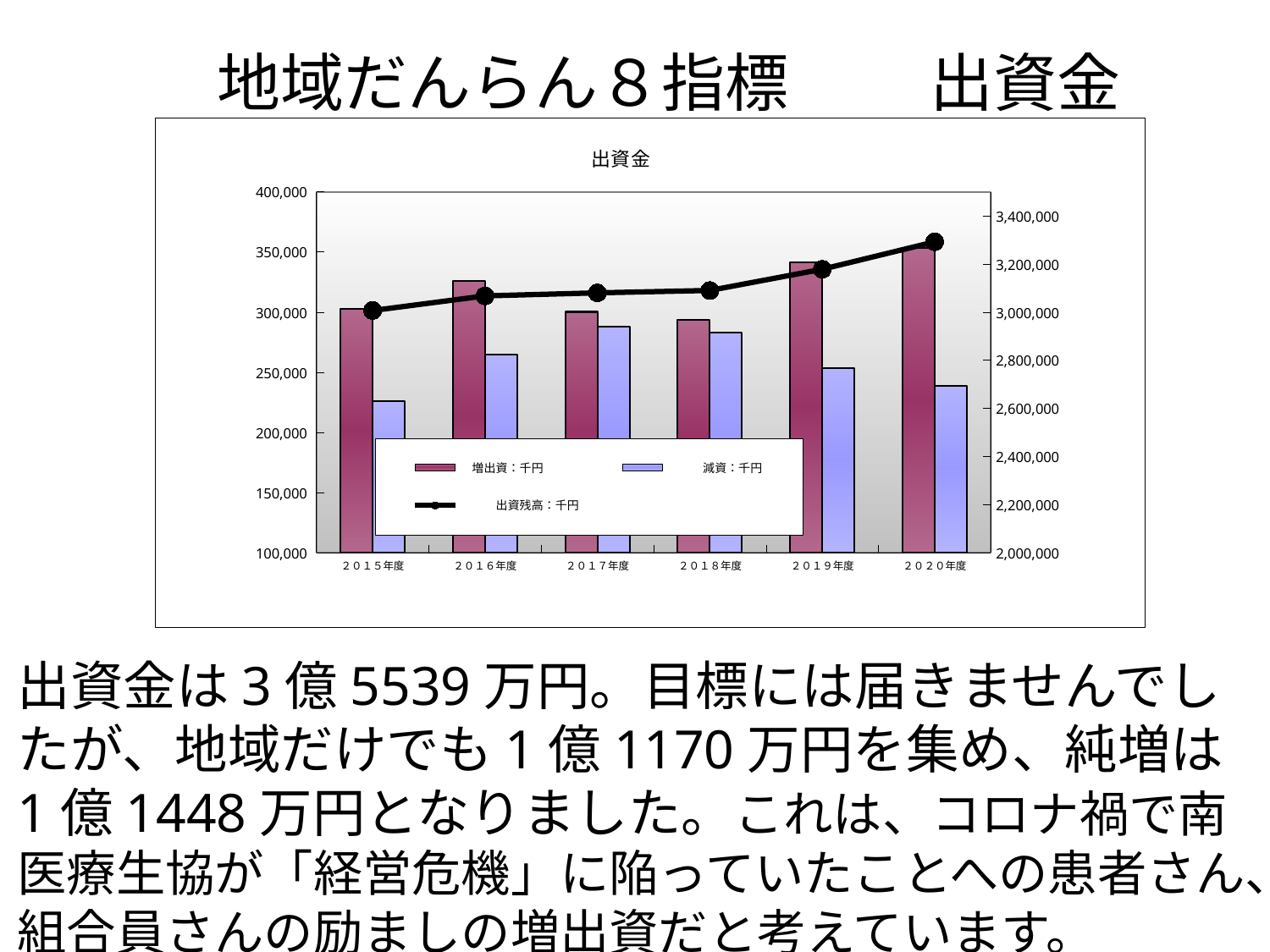
Is the 減資：千円 value for 2017年度 greater or less than 250,000? greater How many fiscal years (categories) are shown on the x axis of the chart? 6 How many series does the chart's legend list? 3 In which fiscal year is the 増出資：千円 bar the highest? 2020年度 What is the title of the chart? 出資金 Does the 出資残高：千円 line rise or fall from 2015年度 to 2020年度? Rises In which fiscal year is the 減資：千円 bar the lowest? 2015年度 For 2016年度, which is larger: the 増出資：千円 bar or the 減資：千円 bar? 増出資：千円 Which series in the legend is drawn as a line with markers? 出資残高：千円 What kind of chart is shown on the slide? A combined bar and line chart Is the 増出資：千円 value for 2016年度 greater or less than 300,000? greater Is the 減資：千円 value for 2015年度 greater or less than 250,000? less